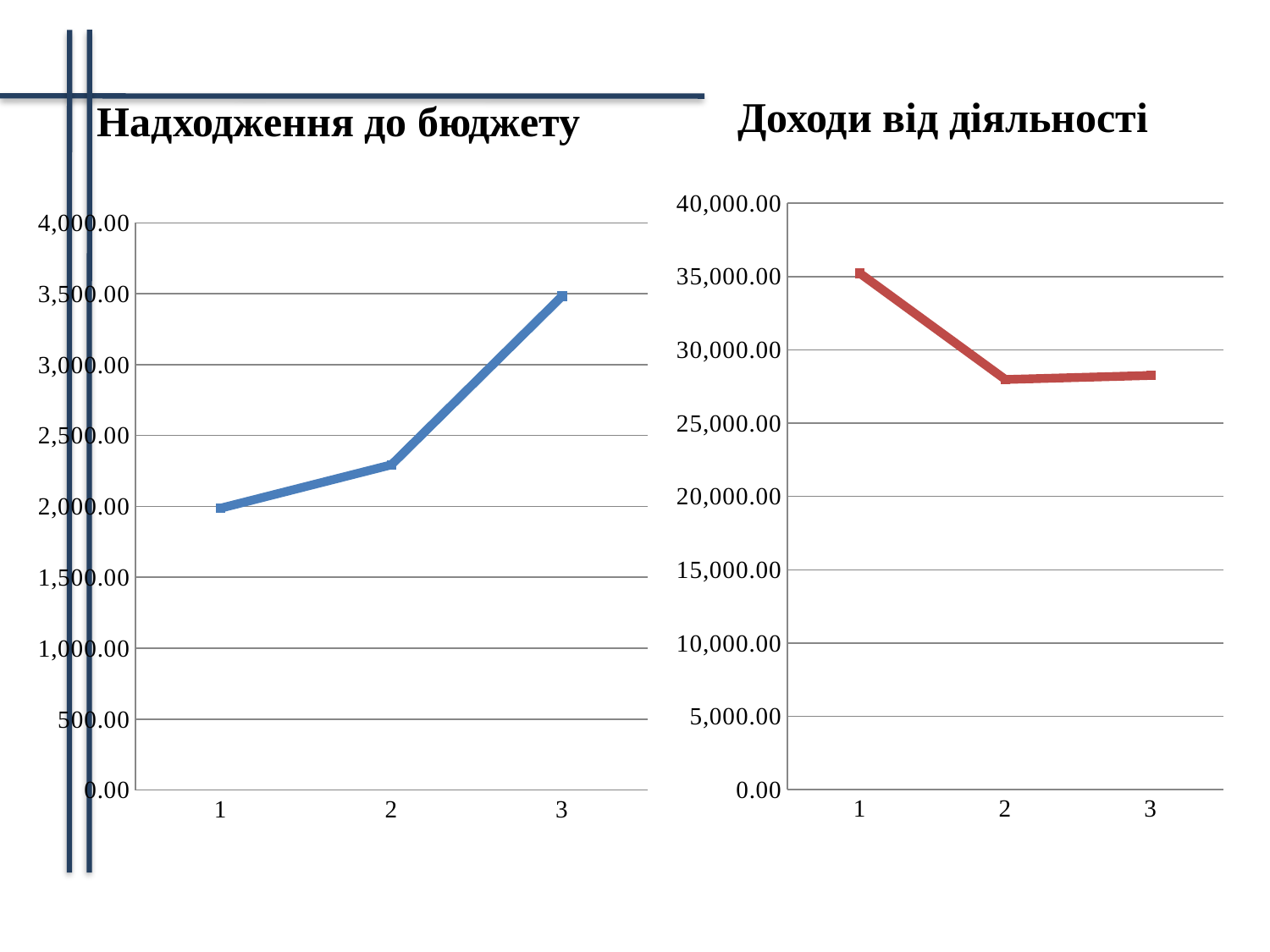
In the 'Надходження до бюджету' chart, is the value for category 3 greater or less than 3,000.00? greater In the 'Надходження до бюджету' chart, how many points are plotted on the line? 3 In the 'Доходи від діяльності' chart, is the value for category 2 greater or less than 30,000.00? less What kind of chart is the 'Надходження до бюджету' chart? line chart In the 'Надходження до бюджету' chart, is the value for category 2 greater or less than 2,500.00? less In the 'Доходи від діяльності' chart, which category has the highest value? 1 In the 'Надходження до бюджету' chart, which category has the highest value? 3 In the 'Надходження до бюджету' chart, which category has the lowest value? 1 What kind of chart is the 'Доходи від діяльності' chart? line chart In the 'Доходи від діяльності' chart, which is larger, the value for category 1 or the value for category 2? category 1 In the 'Доходи від діяльності' chart, how many categories are shown on the x axis? 3 In the 'Надходження до бюджету' chart, do the values rise or fall from category 1 to category 3? rise